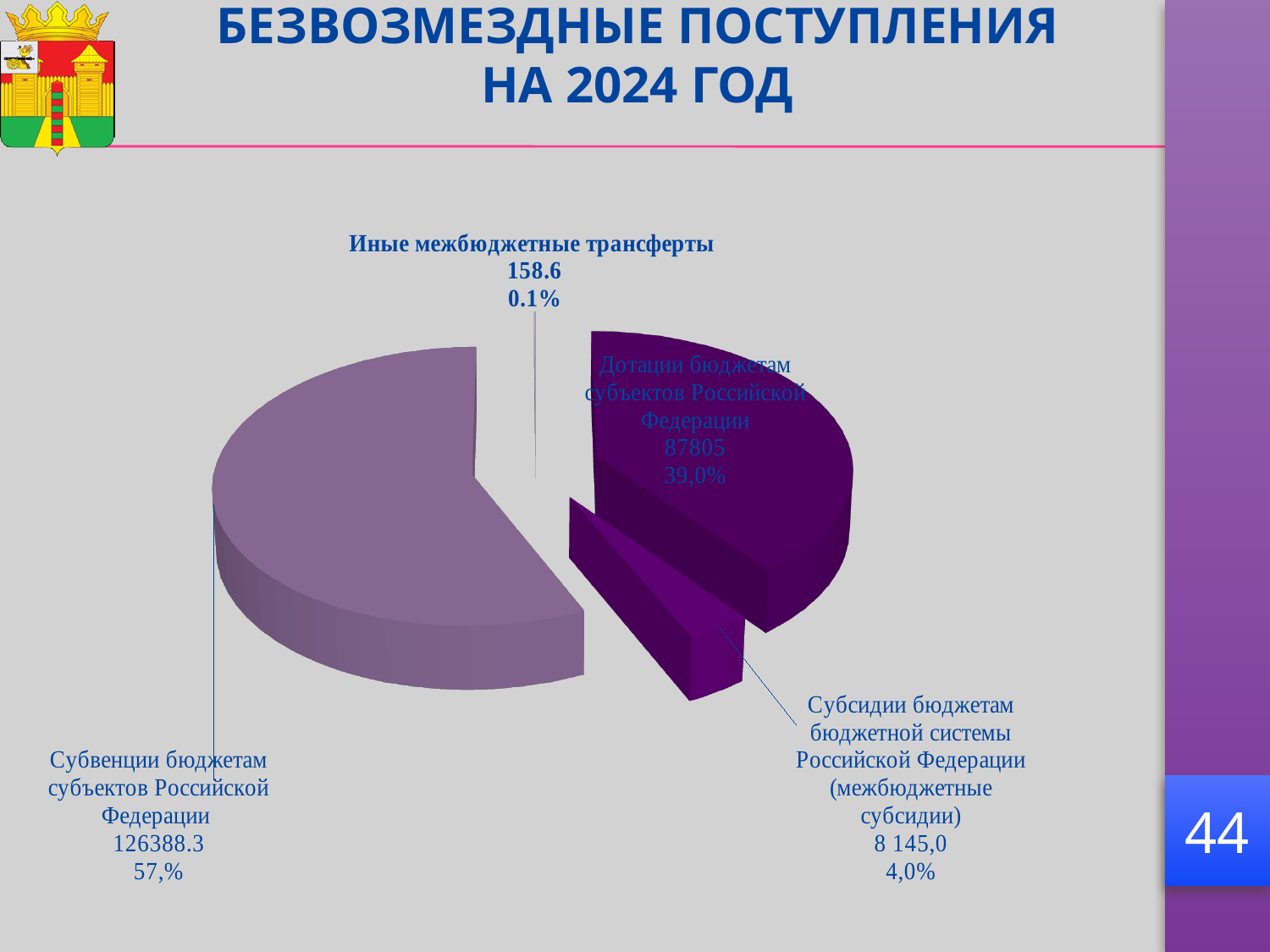
Which category has the smallest slice of the pie? Иные межбюджетные трансферты What is the value shown for Субсидии бюджетам бюджетной системы Российской Федерации (межбюджетные субсидии)? 8 145,0 What share of the pie does Иные межбюджетные трансферты represent? 0.1% What is the value shown for Дотации бюджетам субъектов Российской Федерации? 87805 How many slices does the pie chart have? 4 What kind of chart is shown on the slide? pie chart Which category has the largest slice of the pie? Субвенции бюджетам субъектов Российской Федерации What share of the pie does Дотации бюджетам субъектов Российской Федерации represent? 39,0% What is the value shown for Субвенции бюджетам субъектов Российской Федерации? 126388.3 What is the difference between the values for Субвенции бюджетам субъектов Российской Федерации and Дотации бюджетам субъектов Российской Федерации? 38583.3 What is the value shown for Иные межбюджетные трансферты? 158.6 What share of the pie does Субсидии бюджетам бюджетной системы Российской Федерации (межбюджетные субсидии) represent? 4,0%